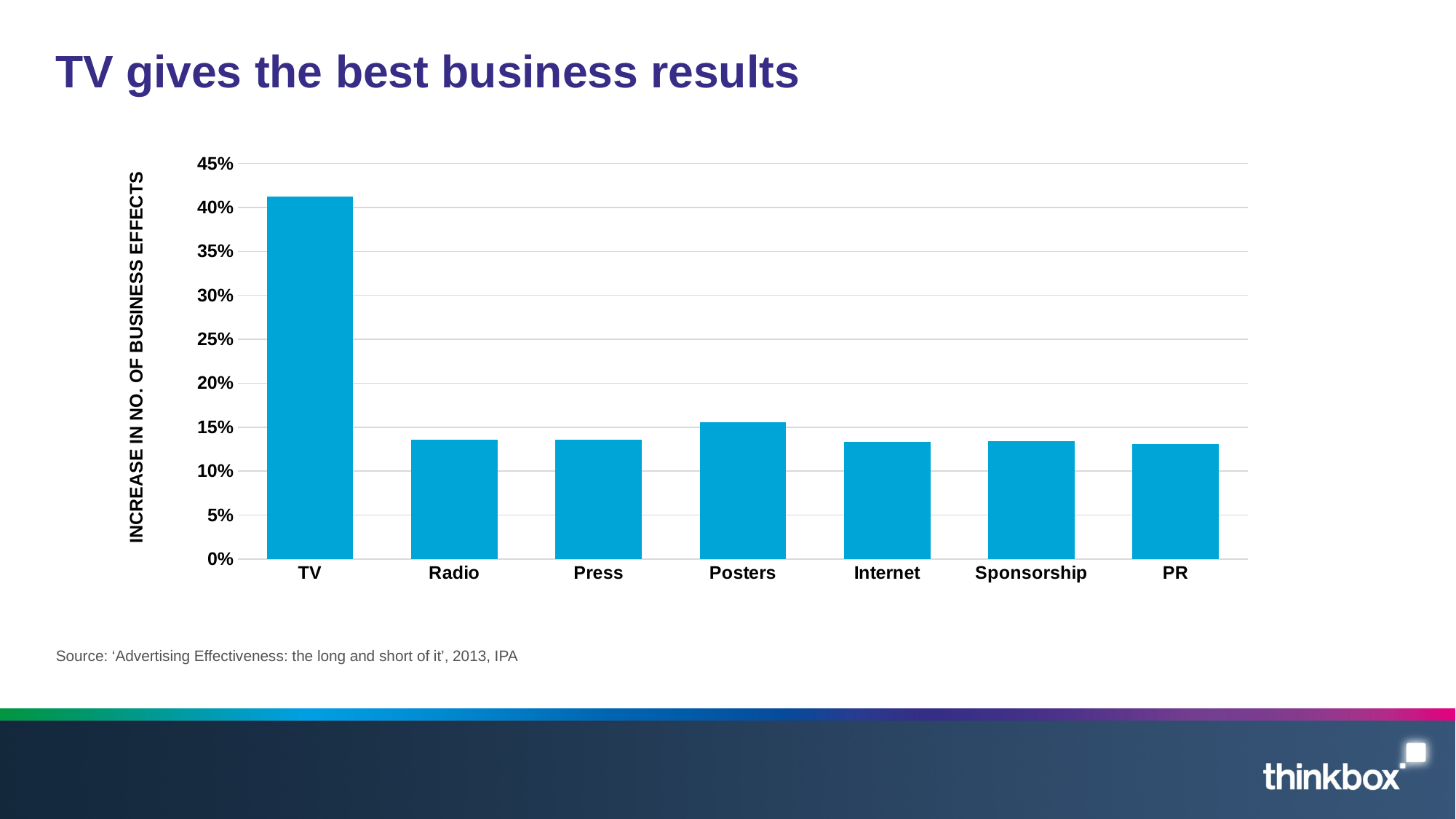
What is the title of the slide? TV gives the best business results Which has a larger value, TV or Press? TV Which category has the highest value in the chart? TV Is the value for PR greater or less than 10%? greater Which has a larger value, Posters or Internet? Posters Is the value for TV greater or less than 40%? greater Is the value for Radio greater or less than 15%? less What kind of chart is shown on the slide? bar chart What is the label on the vertical axis of the chart? INCREASE IN NO. OF BUSINESS EFFECTS How many categories are shown on the x axis of the chart? 7